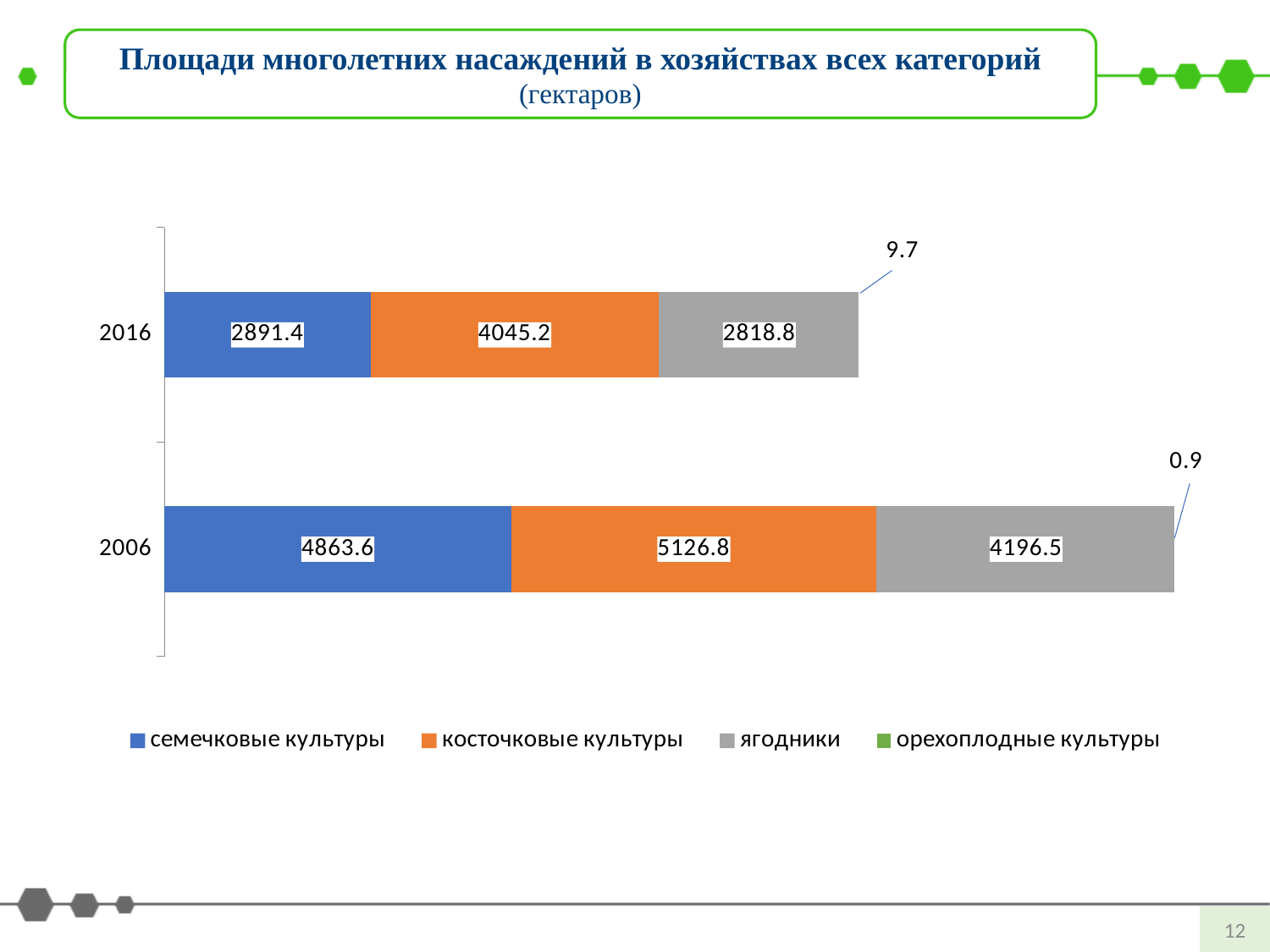
Which series has the smallest value in 2016? орехоплодные культуры What is the value for орехоплодные культуры in 2006? 0.9 What is the value for косточковые культуры in 2006? 5126.8 How many years (categories) are shown on the chart? 2 What is the value for ягодники in 2016? 2818.8 Which series has the largest value in 2006? косточковые культуры What is the total of the stacked bar for 2016? 9765.1 Which is larger: ягодники in 2006 or косточковые культуры in 2016? ягодники in 2006 What is the value for семечковые культуры in 2016? 2891.4 How many series does the legend list? 4 What is the difference between the семечковые культуры values for 2006 and 2016? 1972.2 What type of chart is shown on the slide? stacked bar chart